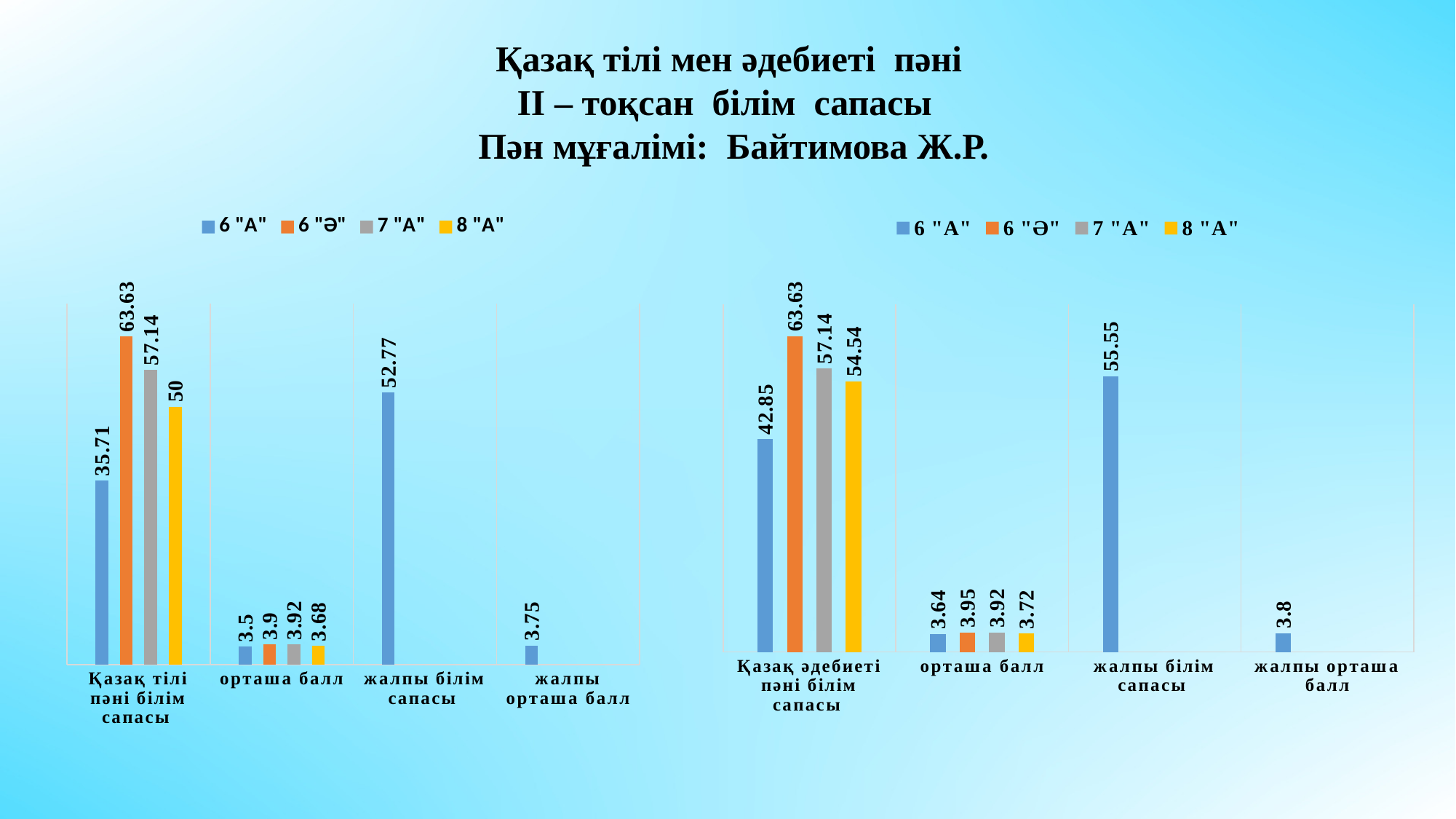
On the left chart, which class has the lowest value in the "Қазақ тілі пәні білім сапасы" category? 6 "А" On the left chart, what is the value shown for "жалпы білім сапасы"? 52.77 On the right chart, is the value for 7 "А" in "Қазақ әдебиеті пәні білім сапасы" larger or smaller than the value for 8 "А"? larger On the right chart, what is the value shown for "жалпы орташа балл"? 3.8 On the right chart, which class has the highest value in the "орташа балл" category? 6 "Ә" On the right chart, what is the value for 6 "А" in the "Қазақ әдебиеті пәні білім сапасы" category? 42.85 How many series does the legend of the right chart list? 4 On the left chart, what is the difference between the 6 "Ә" and 6 "А" values in the "Қазақ тілі пәні білім сапасы" category? 27.92 On the left chart, what is the value for 8 "А" in the "Қазақ тілі пәні білім сапасы" category? 50 On the left chart, what is the value for 6 "Ә" in the "Қазақ тілі пәні білім сапасы" category? 63.63 On the right chart, what is the value for 8 "А" in the "Қазақ әдебиеті пәні білім сапасы" category? 54.54 What type of chart is the left chart? Bar chart